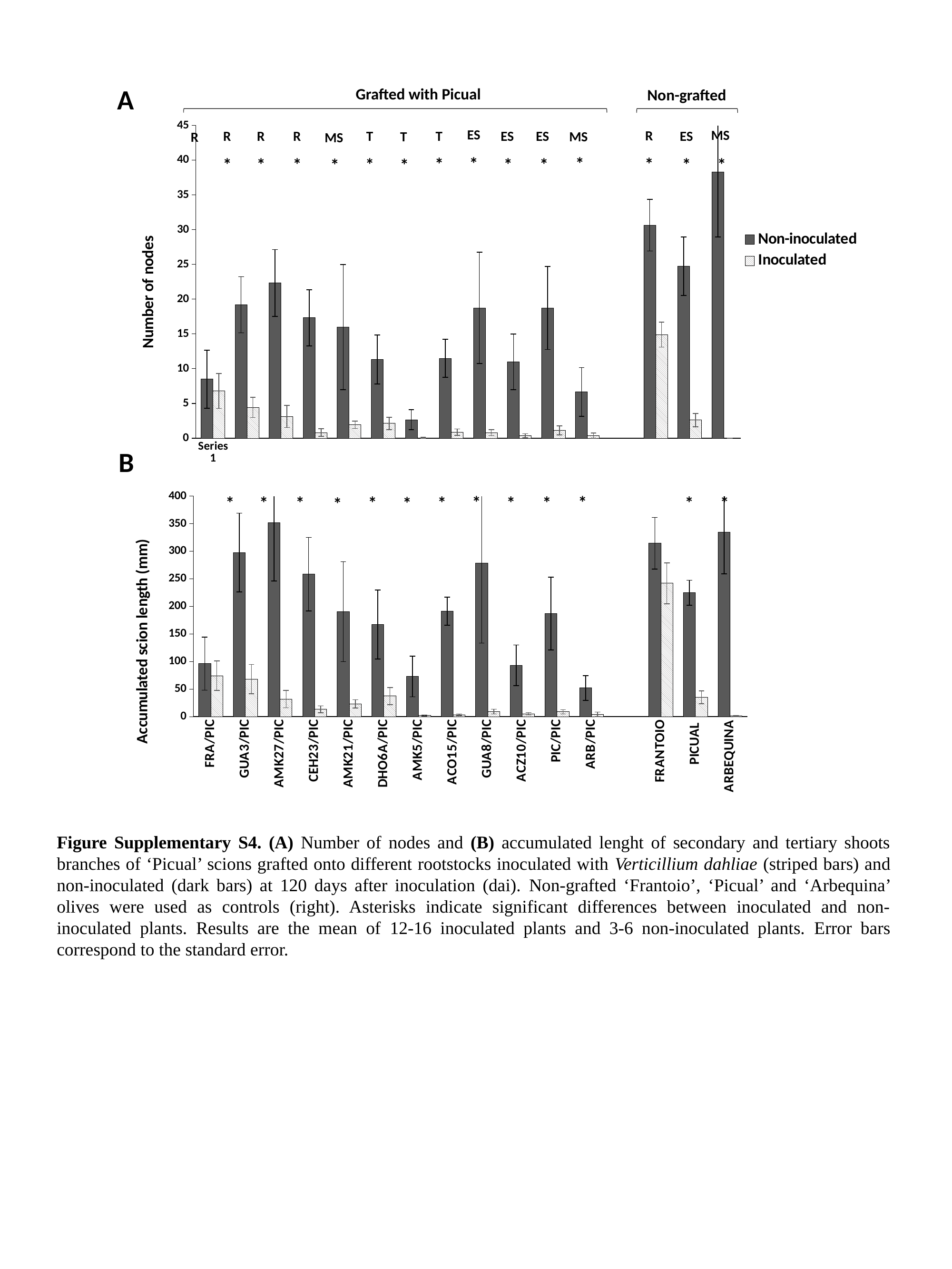
In chart A (Number of nodes), which is larger, the Non-inoculated value for GUA3/PIC or for FRA/PIC? GUA3/PIC In chart A (Number of nodes), which category has the highest Non-inoculated value? ARBEQUINA In chart B (Accumulated scion length), which is larger, the Non-inoculated value for FRANTOIO or for PICUAL? FRANTOIO In chart A (Number of nodes), which category has the highest Inoculated value? FRANTOIO In chart A (Number of nodes), is the Non-inoculated value for AMK27/PIC greater or less than 20? greater How many series does the legend of chart A list? 2 In chart A (Number of nodes), which category has the lowest Non-inoculated value? AMK5/PIC How many categories are shown on the x axis of chart B (Accumulated scion length)? 15 In chart B (Accumulated scion length), which category has the lowest Non-inoculated value? ARB/PIC What kind of chart is chart A (Number of nodes)? bar chart In chart B (Accumulated scion length), is the Inoculated value for FRANTOIO greater or less than 200? greater In chart A (Number of nodes), is the Non-inoculated value for ARBEQUINA greater or less than 35? greater